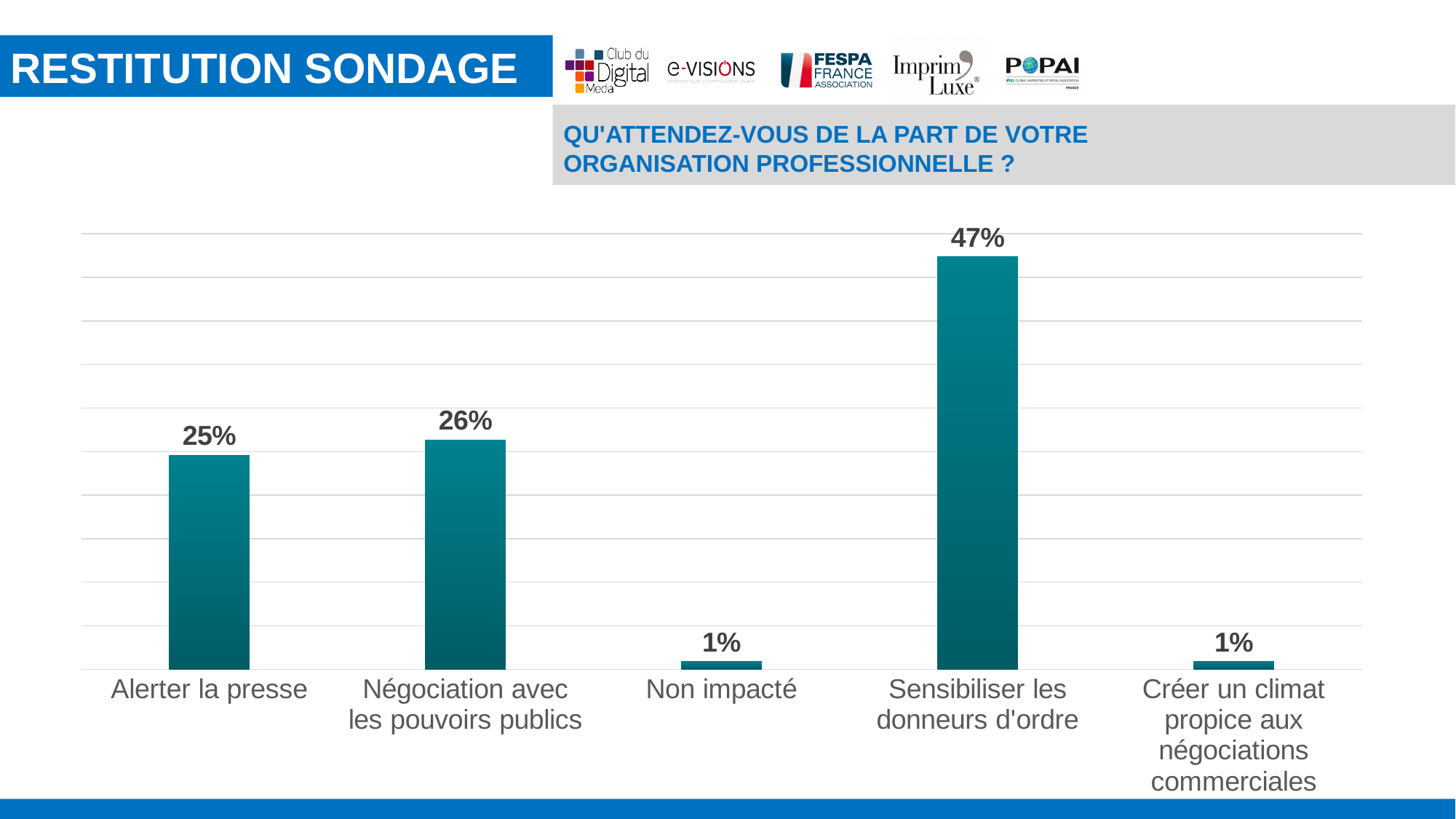
What is the value for "Non impacté"? 1% What is the value for "Négociation avec les pouvoirs publics"? 26% What is the difference between "Négociation avec les pouvoirs publics" and "Alerter la presse"? 1% What question does the chart on the slide answer? Qu'attendez-vous de la part de votre organisation professionnelle ? Which category has the highest value? Sensibiliser les donneurs d'ordre What is the difference between "Sensibiliser les donneurs d'ordre" and "Négociation avec les pouvoirs publics"? 21% Which is larger, the value for "Alerter la presse" or the value for "Sensibiliser les donneurs d'ordre"? Sensibiliser les donneurs d'ordre What is the value for "Sensibiliser les donneurs d'ordre"? 47% What is the value for "Alerter la presse"? 25% What kind of chart is shown on the slide? Bar chart How many categories are shown on the chart? 5 How many categories have a value of 1%? 2